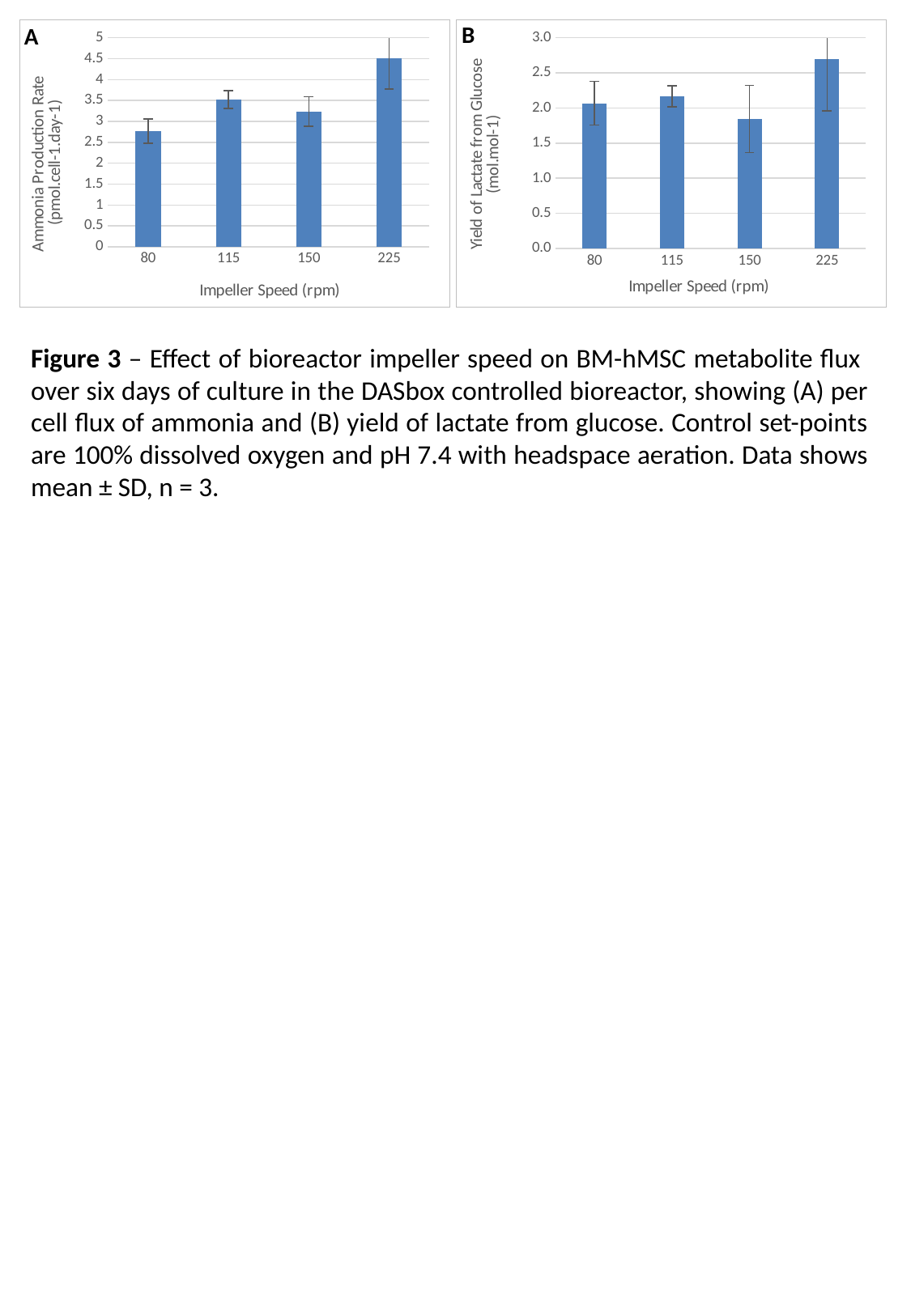
In chart B, which impeller speed has the highest yield of lactate from glucose? 225 In chart A, is the ammonia production rate at 225 rpm greater or less than 4? greater In chart A, which has the higher ammonia production rate, 115 rpm or 150 rpm? 115 In chart A, which impeller speed has the lowest ammonia production rate? 80 In chart B, which impeller speed has the lowest yield of lactate from glucose? 150 What is the x-axis title of chart B? Impeller Speed (rpm) In chart B, is the yield of lactate from glucose at 150 rpm greater or less than 2.0? less In chart B, is the yield of lactate from glucose at 225 rpm greater or less than 2.5? greater How many impeller speed categories are shown in chart A? 4 What kind of chart is chart A (Ammonia Production Rate)? bar chart In chart A, which impeller speed has the highest ammonia production rate? 225